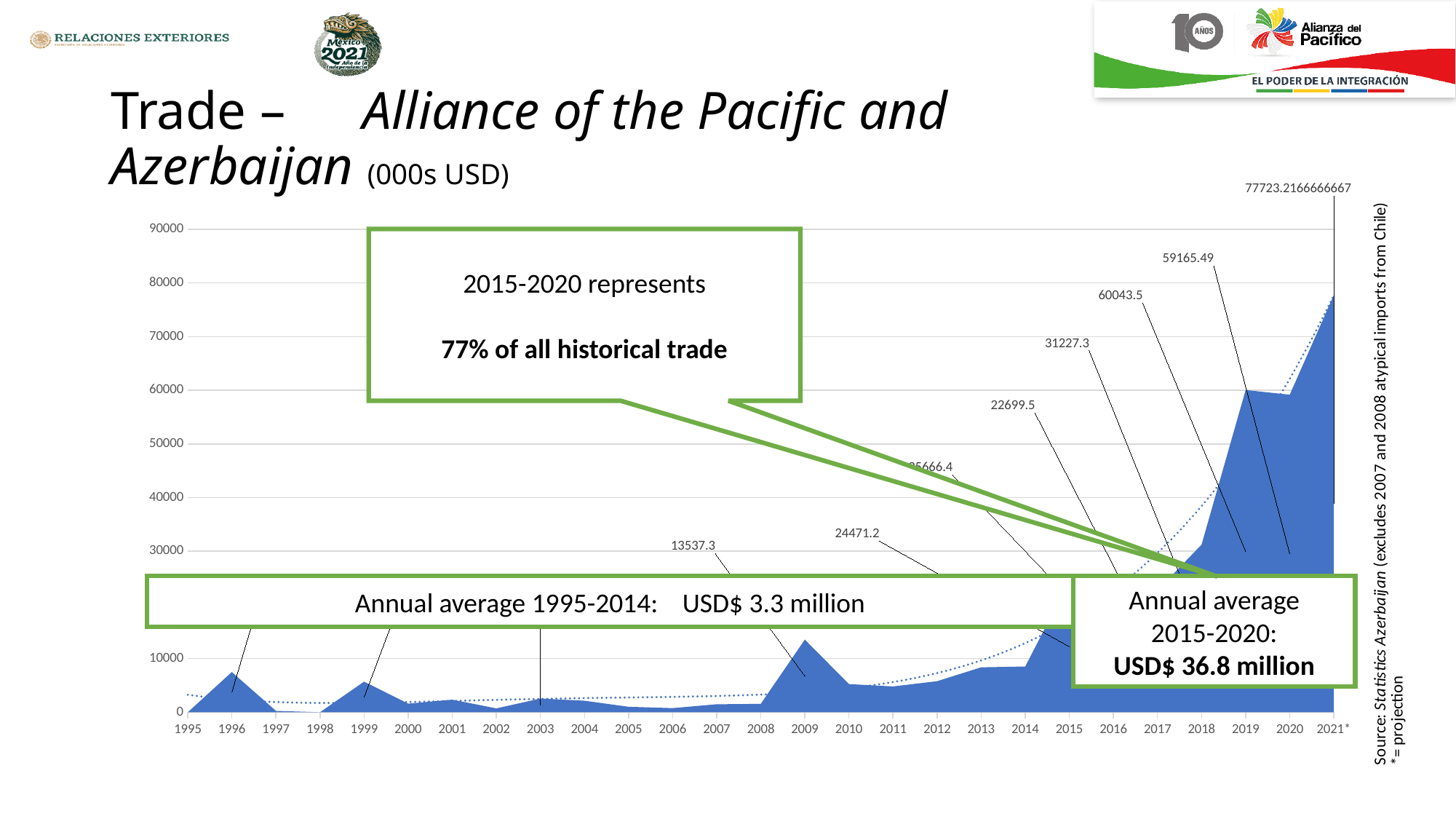
What is the value shown for 2021* on the chart? 77723.2166666667 Is the value for 2009 greater or less than 10000? greater Which year has the highest trade value on the chart? 2021* According to the callout on the chart, what share of all historical trade does 2015-2020 represent? 77% Which is larger, the value for 2021* or the value for 2019? 2021* What type of chart is shown on the slide? Area chart Is the value for 2019 greater or less than 50000? greater How many years are shown on the x axis of the chart? 27 According to the callout on the chart, what was the annual average trade for 2015-2020? USD$ 36.8 million Which is larger, the value for 2009 or the value for 2010? 2009 Overall, do the trade values rise or fall from 1995 to 2021*? rise Is the value for 1996 greater or less than 10000? less